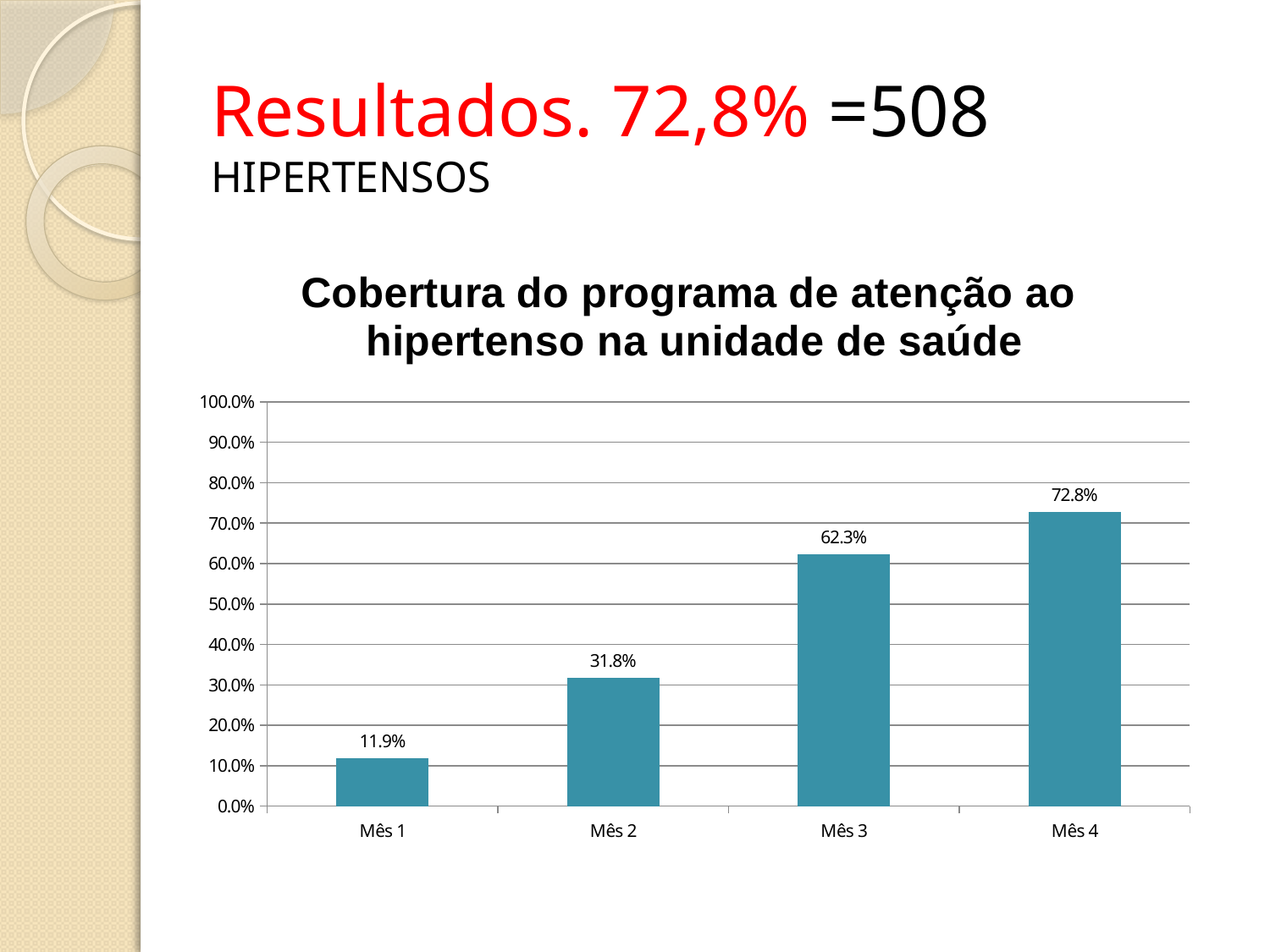
What kind of chart is shown on the slide? Bar chart What is the difference between the values for Mês 2 and Mês 1? 19.9% Which month has the lowest coverage value? Mês 1 Which is larger, the value for Mês 2 or the value for Mês 3? Mês 3 What is the value for Mês 3? 62.3% Do the values rise or fall from Mês 1 to Mês 4? Rise What is the value for Mês 1? 11.9% What is the value for Mês 2? 31.8% What is the value for Mês 4? 72.8% What is the difference between the values for Mês 4 and Mês 3? 10.5% How many months are shown on the x axis? 4 Which month has the highest coverage value? Mês 4